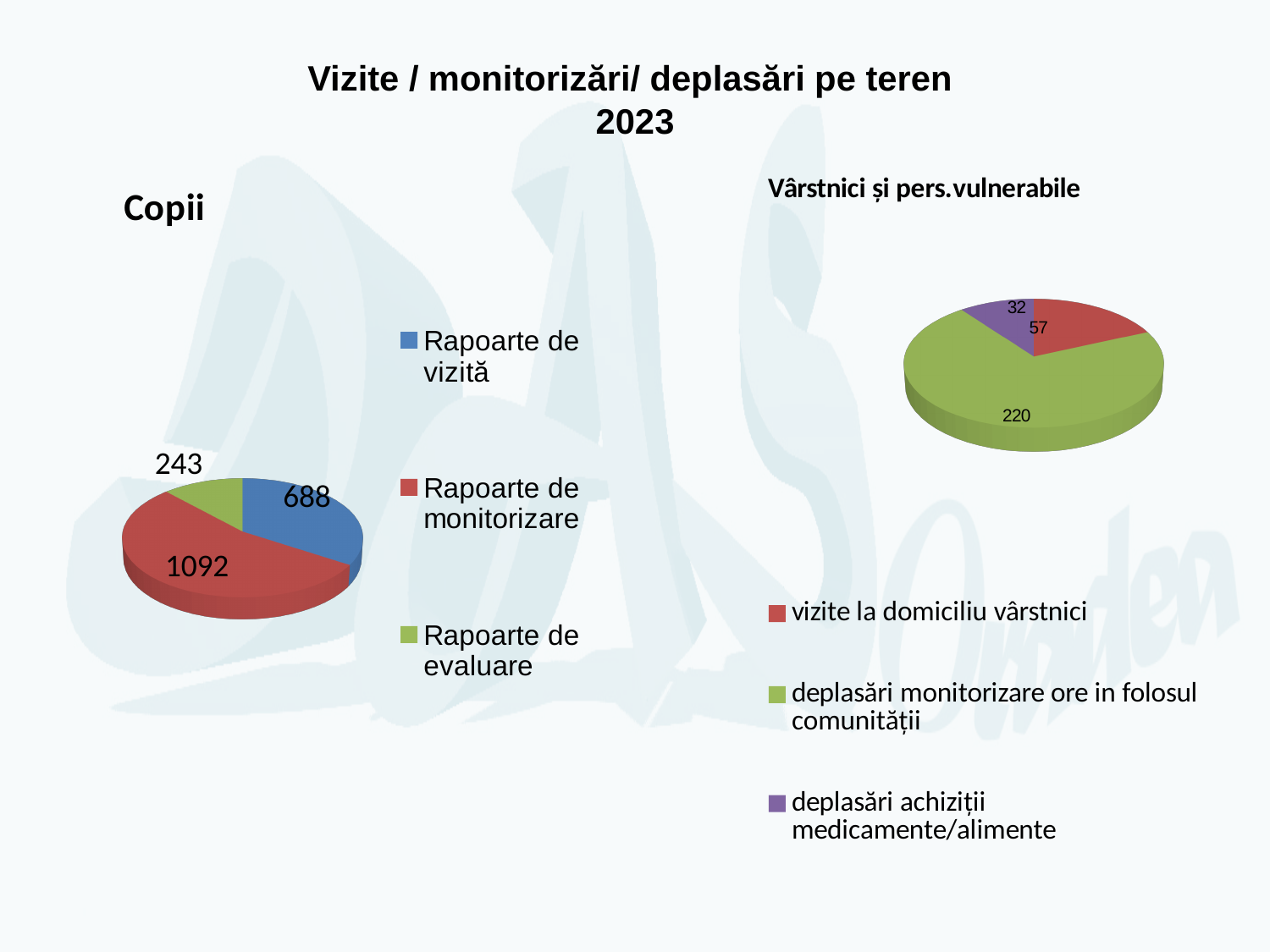
What type of chart is the 'Copii' chart? Pie chart In the 'Copii' chart, which is larger: Rapoarte de vizită or Rapoarte de evaluare? Rapoarte de vizită In the 'Vârstnici și pers.vulnerabile' chart, which category has the smallest value? deplasări achiziții medicamente/alimente In the 'Copii' chart, what is the value for Rapoarte de monitorizare? 1092 How many slices does the 'Vârstnici și pers.vulnerabile' pie chart have? 3 In the 'Copii' chart, what is the value for Rapoarte de evaluare? 243 What is the total of all slices in the 'Copii' chart? 2023 In the 'Vârstnici și pers.vulnerabile' chart, what is the difference between vizite la domiciliu vârstnici and deplasări achiziții medicamente/alimente? 25 In the 'Copii' chart, what is the difference between Rapoarte de monitorizare and Rapoarte de vizită? 404 In the 'Copii' chart, which category has the largest value? Rapoarte de monitorizare In the 'Vârstnici și pers.vulnerabile' chart, what is the value for deplasări monitorizare ore in folosul comunității? 220 In the 'Vârstnici și pers.vulnerabile' chart, what is the value for deplasări achiziții medicamente/alimente? 32